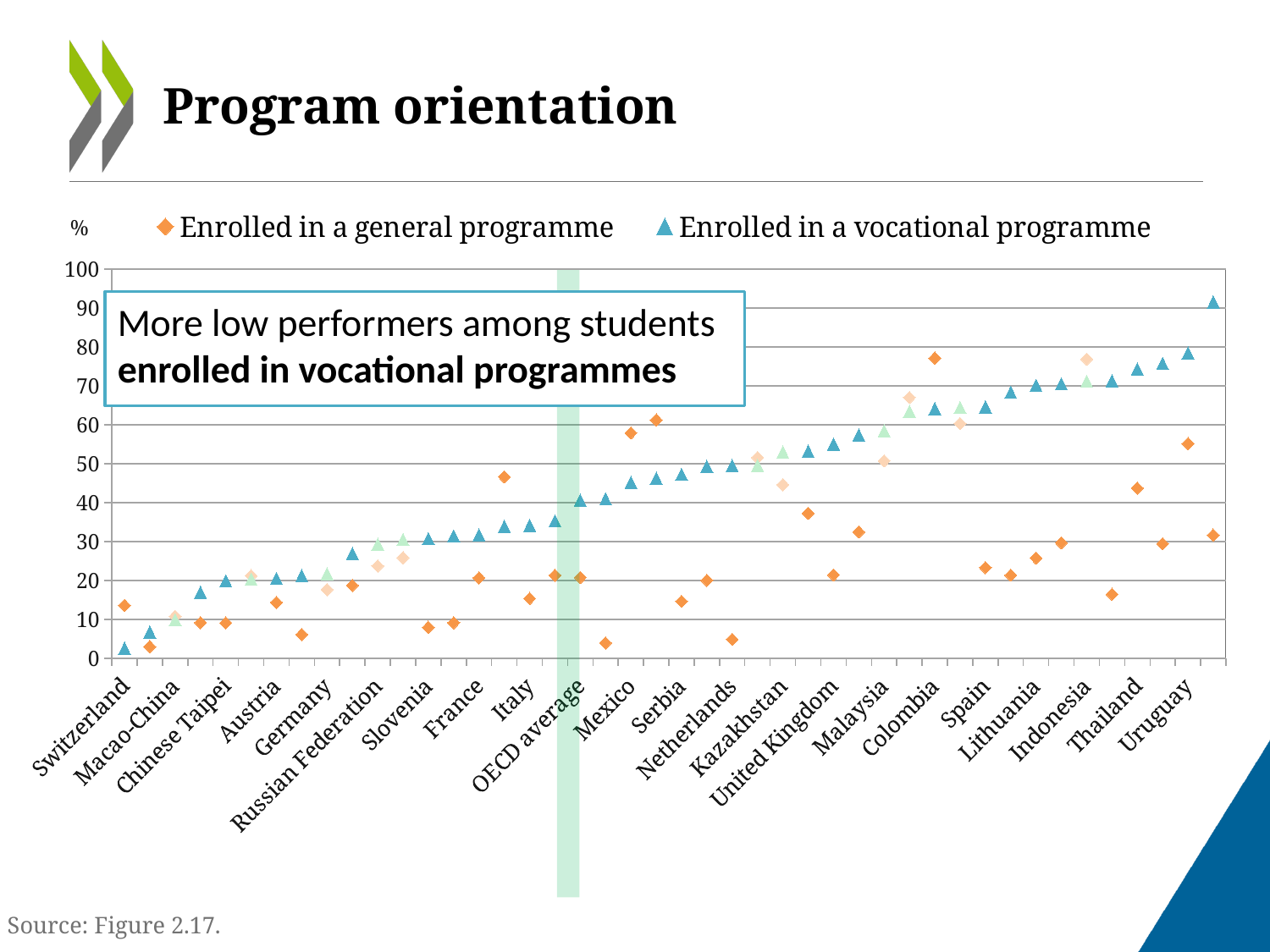
Which labelled country has the lowest value for 'Enrolled in a vocational programme'? Switzerland Is the value for 'Enrolled in a vocational programme' for the OECD average greater or less than 30? greater Which labelled country has the highest value for 'Enrolled in a vocational programme'? Uruguay For Uruguay, which is larger: the value for 'Enrolled in a general programme' or 'Enrolled in a vocational programme'? Enrolled in a vocational programme Is the value for 'Enrolled in a vocational programme' for Switzerland greater or less than 10? less For Switzerland, which is larger: the value for 'Enrolled in a general programme' or 'Enrolled in a vocational programme'? Enrolled in a general programme What is the title of the slide containing the chart? Program orientation How many series does the legend list? 2 Is the value for 'Enrolled in a vocational programme' for Uruguay greater or less than 80? less What are the two series named in the legend? Enrolled in a general programme; Enrolled in a vocational programme Do the values for 'Enrolled in a vocational programme' rise or fall from left to right along the x axis? Rise What kind of chart is shown on the slide? Scatter (dot) chart